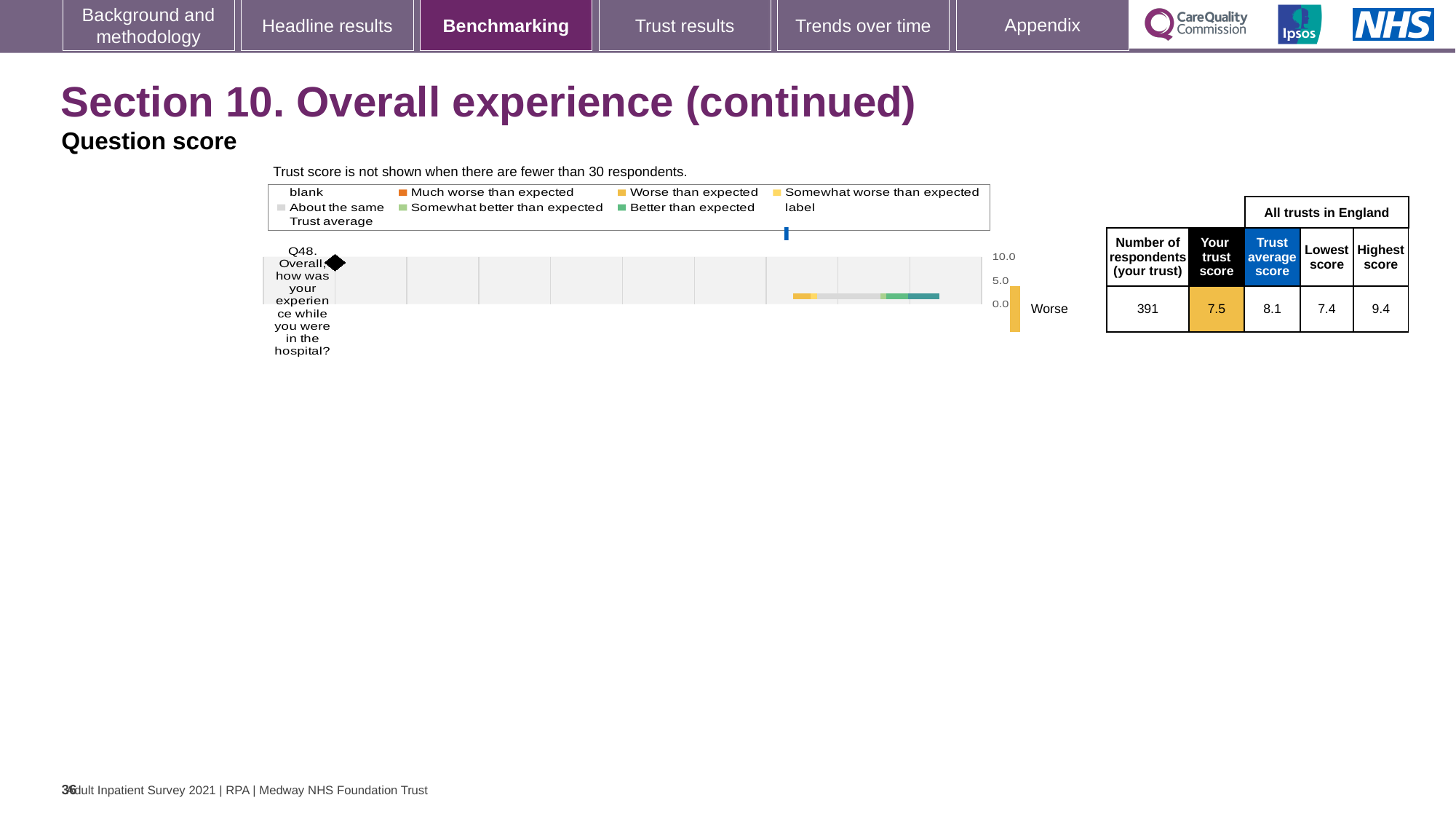
What is the difference between the trust average score and your trust score for Q48? 0.6 How many respondents from the trust answered Q48? 391 What is the lowest score among all trusts in England for Q48? 7.4 What kind of chart is used to show the Q48 benchmark? Bar chart Is your trust score for Q48 greater or less than 5.0? greater How many questions are plotted on the chart? 1 What is the 'Your trust score' value for Q48 (Overall, how was your experience while you were in the hospital?)? 7.5 What is the highest score among all trusts in England for Q48? 9.4 What is the difference between the highest score and the lowest score for Q48? 2.0 What benchmark category label is shown next to the chart for Q48? Worse Which is larger for Q48: your trust score or the trust average score? Trust average score What is the trust average score across all trusts in England for Q48? 8.1